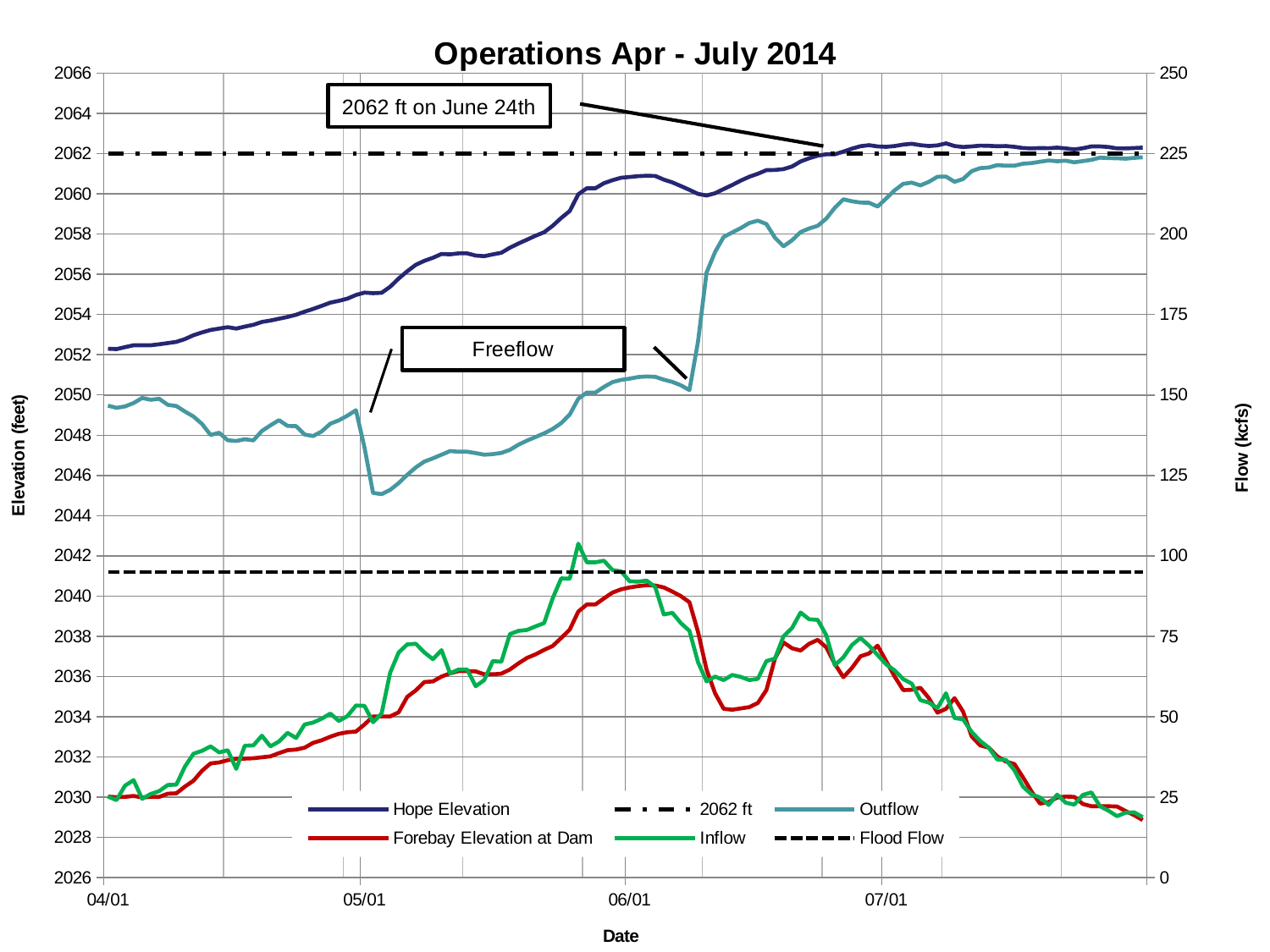
Is the Forebay Elevation at Dam value at 04/01 greater or less than 2032 feet? less What text is in the annotation box pointing to the drop in Outflow around early May? Freeflow How many date labels are shown on the x axis? 4 Does the Forebay Elevation at Dam series rise or fall from 07/01 to the end of the chart? Fall At 07/01, which is larger, Outflow or Inflow? Outflow What is the title of the chart? Operations Apr - July 2014 On what date does the annotation say the elevation reached 2062 ft? June 24th What kind of chart is shown on the slide? Line chart Is the Outflow value at 07/01 greater or less than 200 kcfs? greater Does the Hope Elevation series generally rise or fall from 04/01 to the end of the chart? Rise Is the Hope Elevation value at 04/01 greater or less than 2050 feet? greater How many series does the legend list? 6